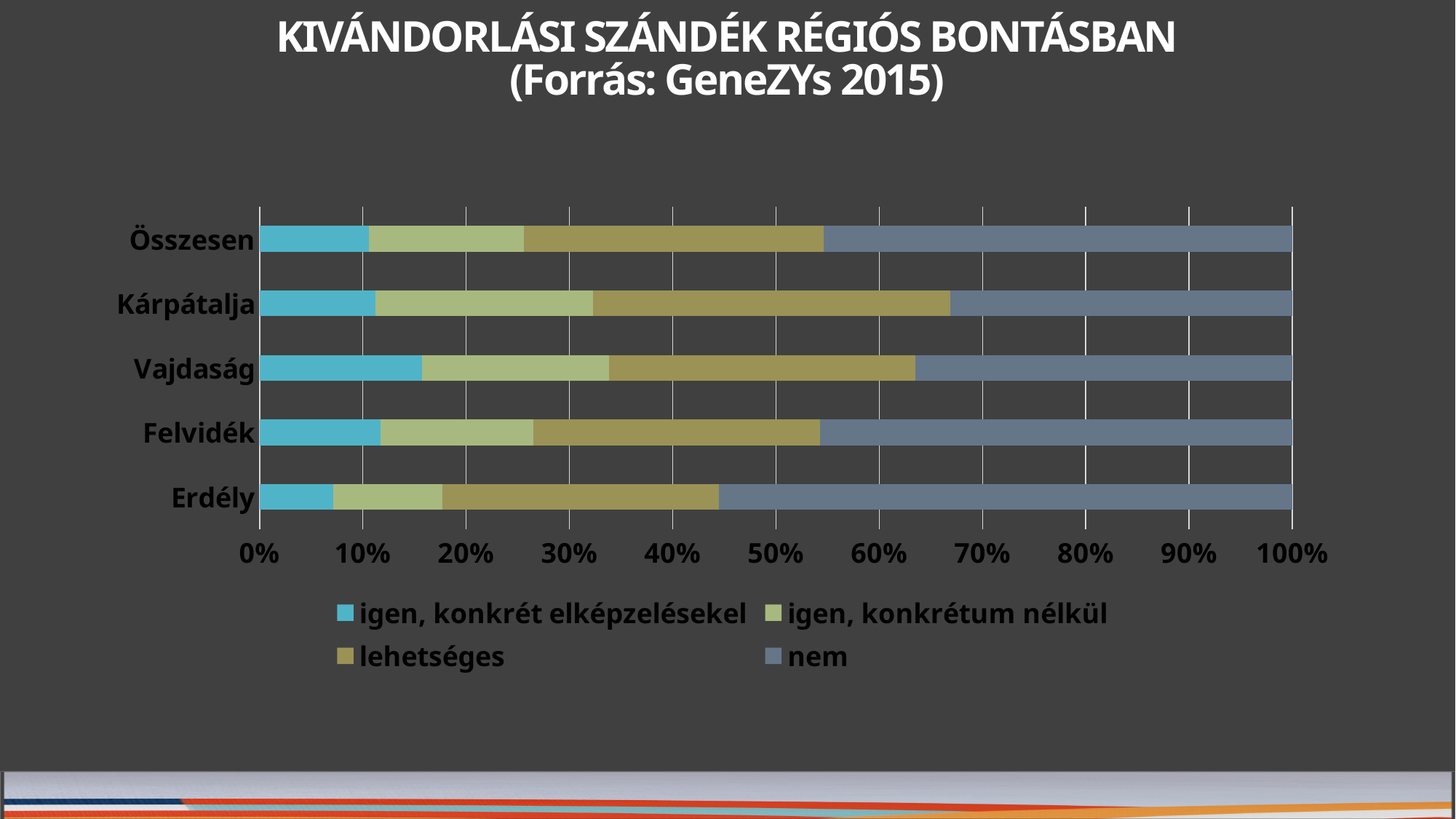
Which region has the largest "nem" segment? Erdély Is the "igen, konkrét elképzelésekel" value for Vajdaság greater or less than 10%? greater Is the "nem" value for Erdély greater or less than 50%? greater Which region has the smallest "igen, konkrét elképzelésekel" segment? Erdély How many series does the legend list? 4 Is the "igen, konkrét elképzelésekel" value for Erdély greater or less than 10%? less What kind of chart is shown on the slide? stacked bar chart Which is larger: the "nem" segment for Erdély or for Felvidék? Erdély Which region has the largest "igen, konkrét elképzelésekel" segment? Vajdaság What is the source cited in the chart title? GeneZYs 2015 How many regions (categories) are shown on the chart? 5